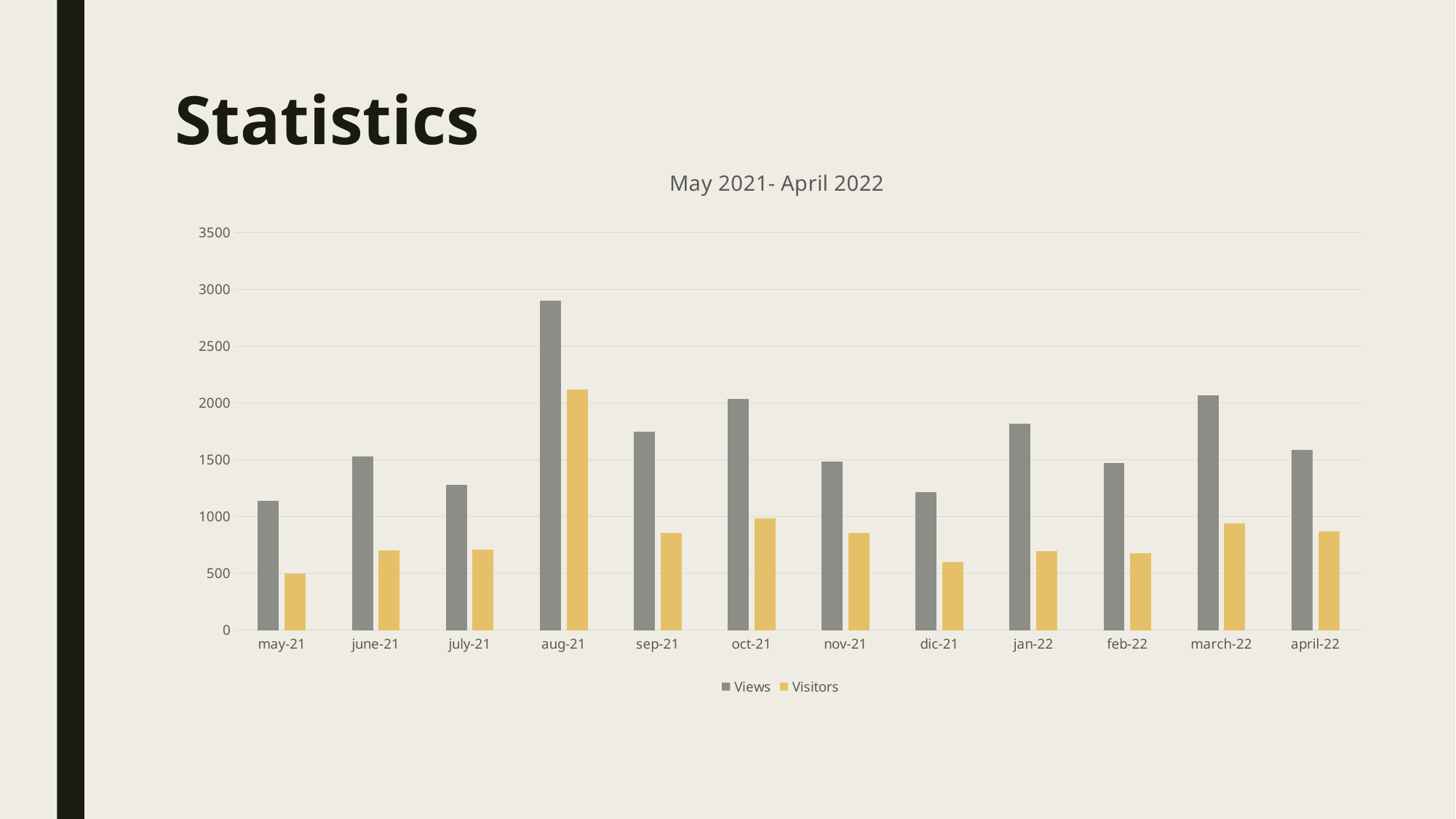
Which month has the lowest value for Visitors? may-21 Which month has the highest value for Visitors? aug-21 Is the value for Visitors in sep-21 greater or less than 1000? less Which is larger in aug-21, Views or Visitors? Views Is the value for Views in aug-21 greater or less than 2500? greater Which month has the highest value for Views? aug-21 How many months are shown on the x axis? 12 What kind of chart is shown on the slide? bar chart Is the value for Visitors in aug-21 greater or less than 2000? greater How many series does the legend list? 2 What is the title of the chart? May 2021- April 2022